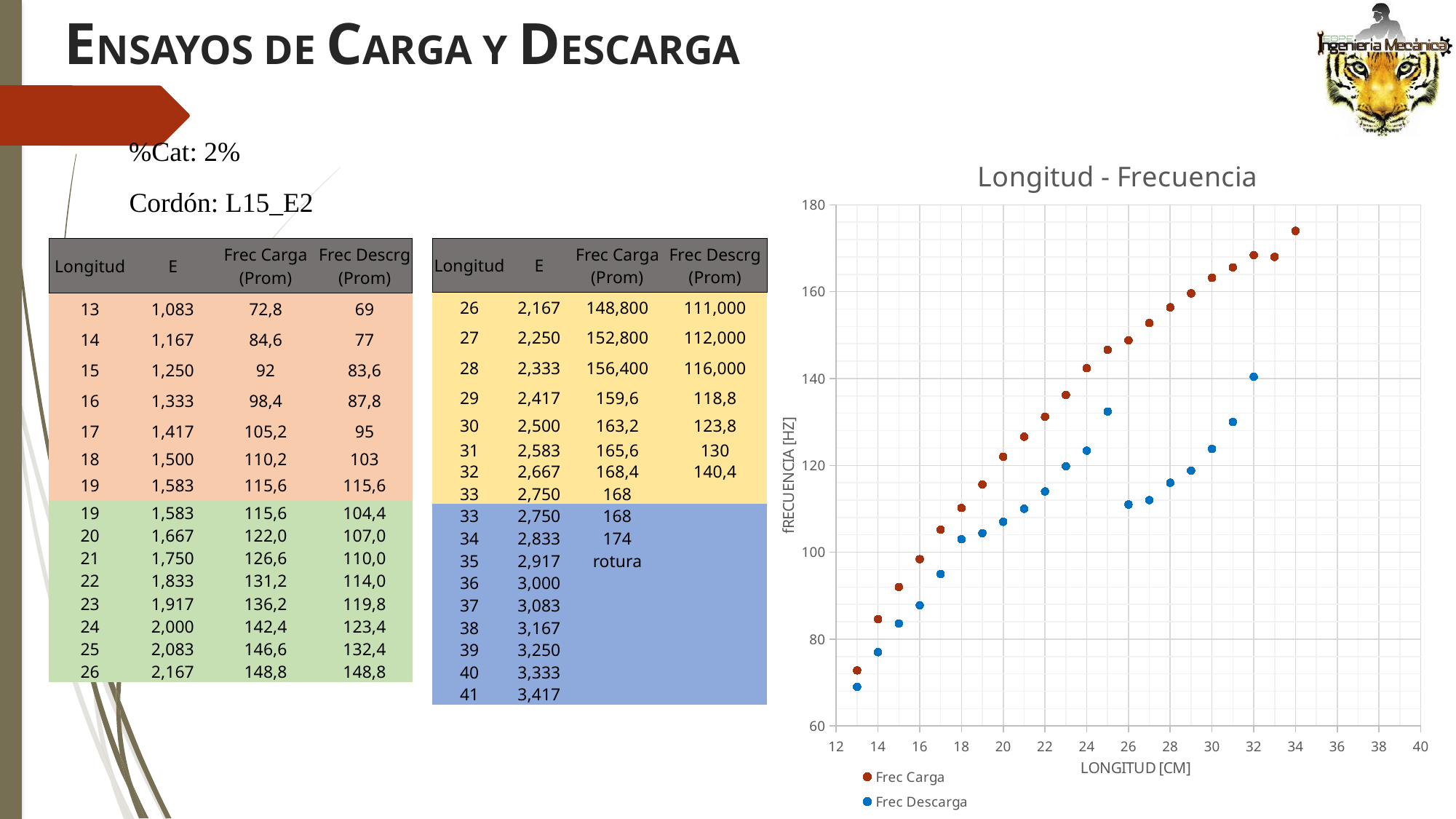
How many series does the chart's legend list? 2 Is the Frec Carga value at longitud 22 greater or less than 120? greater Does the Frec Carga series rise or fall as longitud increases? rise What is the label of the chart's x axis? LONGITUD [CM] Is the Frec Carga value at longitud 34 greater or less than 160? greater What is the title of the chart? Longitud - Frecuencia What kind of chart is shown on the slide? scatter chart Which series reaches the highest frequency on the chart? Frec Carga At longitud 30, which series has the higher frequency, Frec Carga or Frec Descarga? Frec Carga Is the Frec Descarga value at longitud 32 greater or less than 120? greater